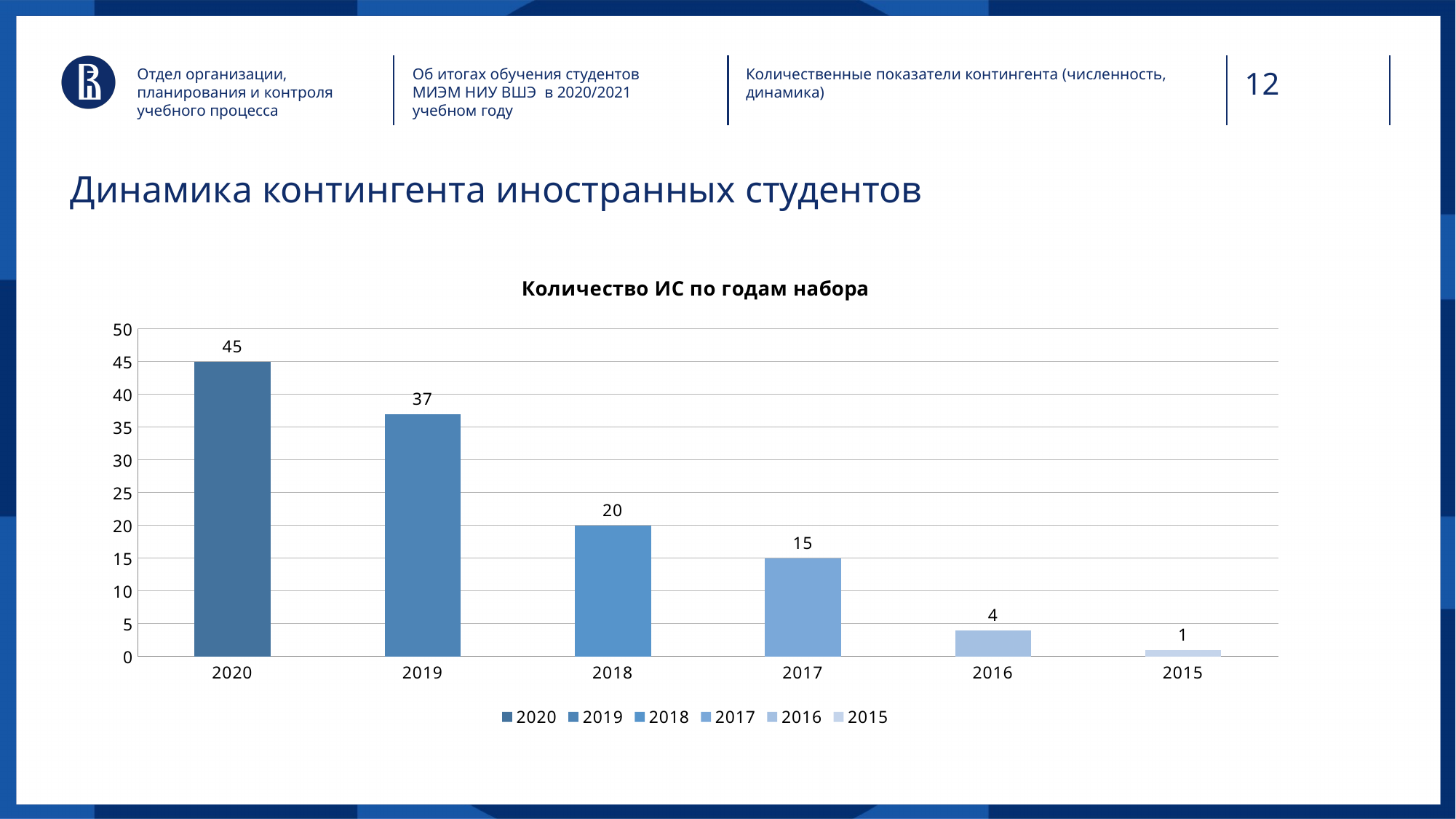
What is the value for 2017? 15 What is the value for 2020? 45 How many entries does the legend list? 6 What kind of chart is shown? bar chart Which is larger, the value for 2019 or the value for 2018? 2019 What is the difference between the values for 2018 and 2016? 16 What is the value for 2015? 1 What is the title of the chart? Количество ИС по годам набора Which year has the lowest value? 2015 What is the difference between the values for 2020 and 2019? 8 Which year has the highest value? 2020 How many years are shown on the x axis? 6